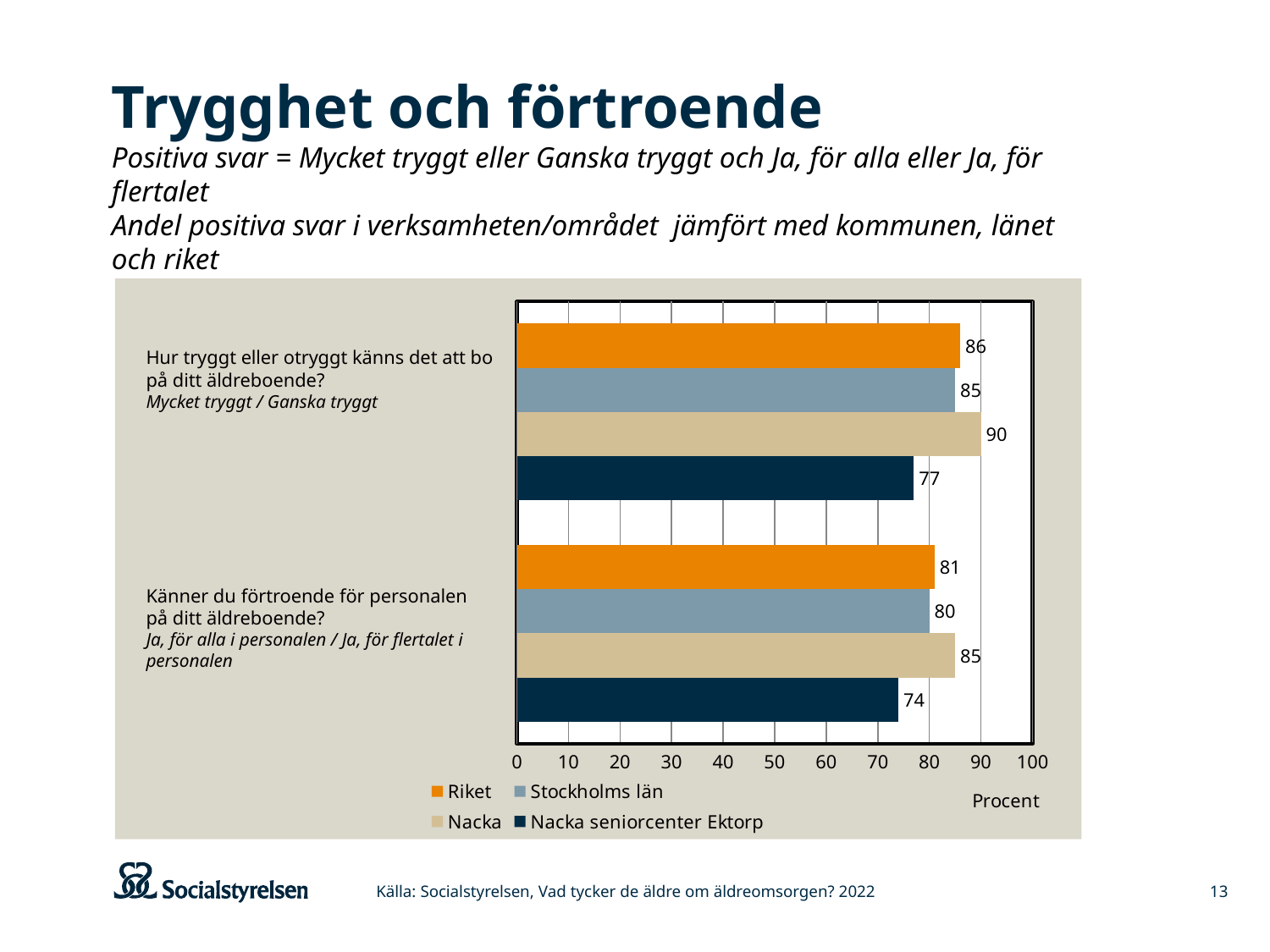
Which series has the highest value on the question "Känner du förtroende för personalen på ditt äldreboende?"? Nacka What label is shown on the horizontal axis of the chart? Procent What is the difference between Nacka and Nacka seniorcenter Ektorp on the question "Hur tryggt eller otryggt känns det att bo på ditt äldreboende?"? 13 How many question categories are shown on the chart? 2 How many series does the legend list? 4 What is the value for Nacka seniorcenter Ektorp on the question "Känner du förtroende för personalen på ditt äldreboende?"? 74 Which is larger on the question "Känner du förtroende för personalen på ditt äldreboende?": Riket or Nacka seniorcenter Ektorp? Riket What is the value for Nacka on the question "Hur tryggt eller otryggt känns det att bo på ditt äldreboende?"? 90 What kind of chart is shown on the slide? bar chart Which series has the lowest value on the question "Hur tryggt eller otryggt känns det att bo på ditt äldreboende?"? Nacka seniorcenter Ektorp What is the value for Stockholms län on the question "Hur tryggt eller otryggt känns det att bo på ditt äldreboende?"? 85 What is the value for Riket on the question "Känner du förtroende för personalen på ditt äldreboende?"? 81